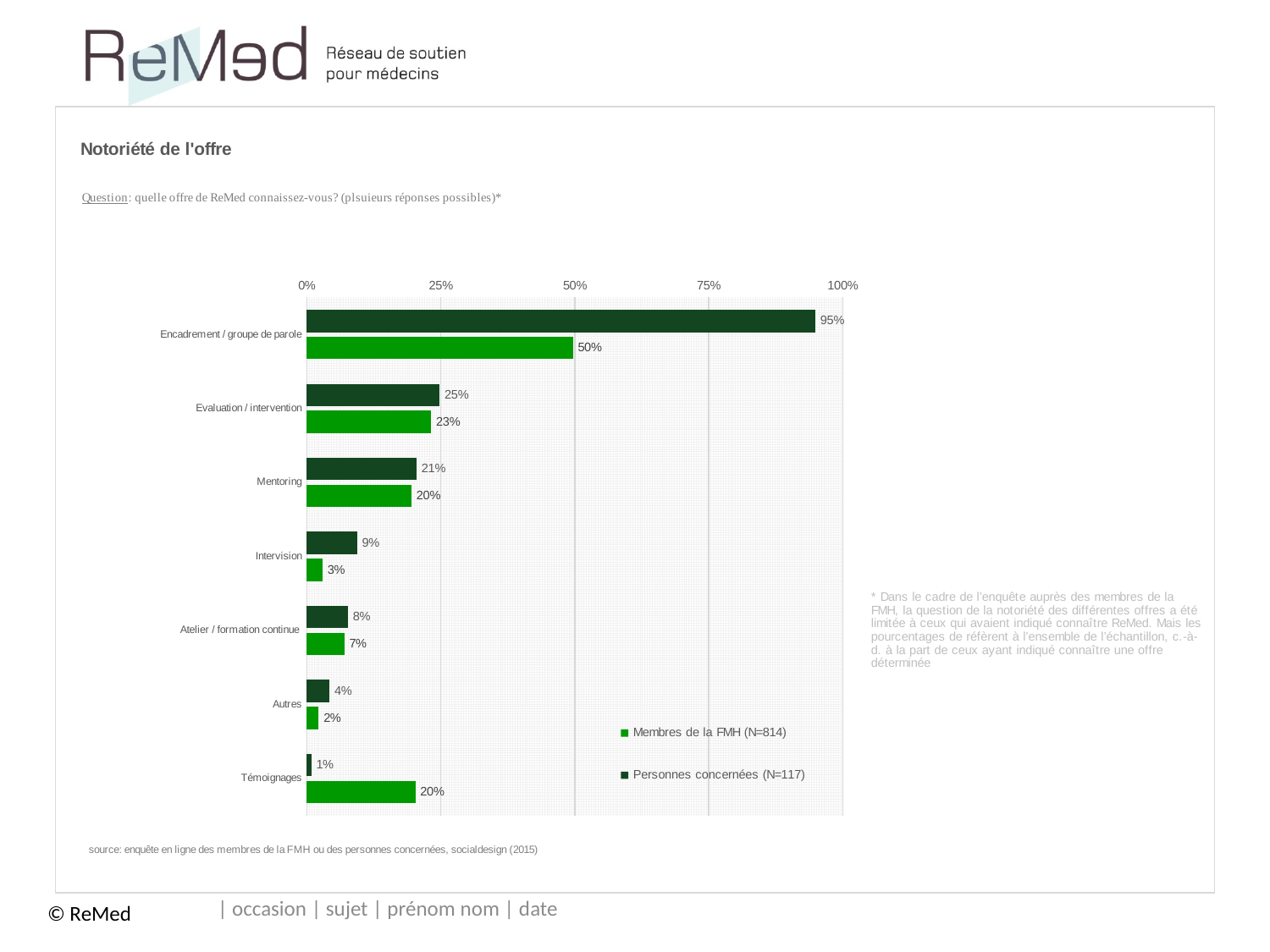
What kind of chart is shown on the slide? bar chart What is the title of the chart section on the slide? Notoriété de l'offre What is the value for Encadrement / groupe de parole for Membres de la FMH (N=814)? 50% What is the value for Témoignages for Membres de la FMH (N=814)? 20% What is the difference between the Personnes concernées (N=117) and Membres de la FMH (N=814) values for Encadrement / groupe de parole? 45% How many series does the legend list? 2 What is the value for Encadrement / groupe de parole for Personnes concernées (N=117)? 95% What is the value for Intervision for Personnes concernées (N=117)? 9% For Témoignages, which series has the larger value: Membres de la FMH (N=814) or Personnes concernées (N=117)? Membres de la FMH (N=814) How many categories are shown on the chart? 7 Which category has the lowest value for Personnes concernées (N=117)? Témoignages Which category has the highest value for Personnes concernées (N=117)? Encadrement / groupe de parole